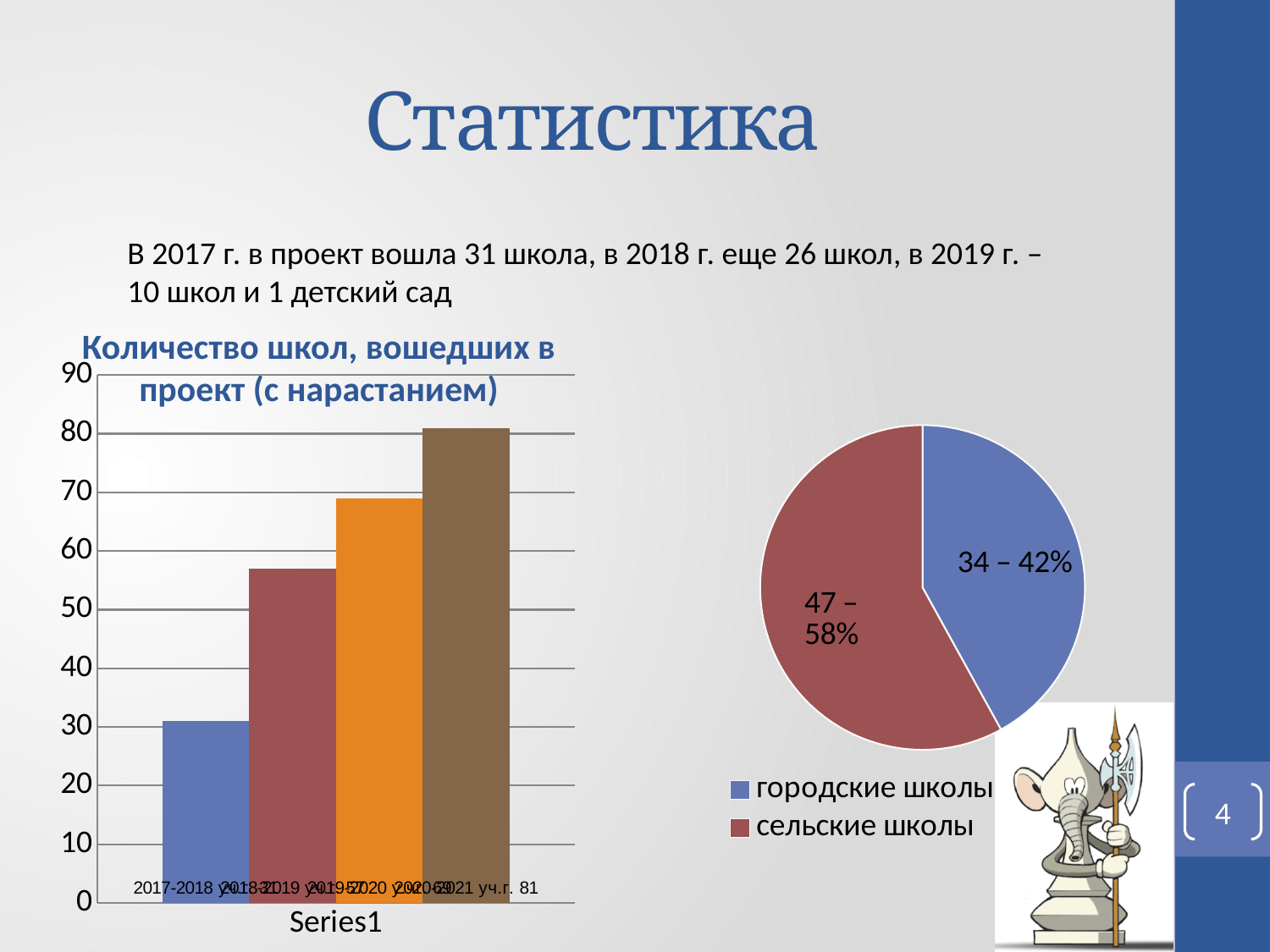
In the bar chart "Количество школ, вошедших в проект (с нарастанием)", which category has the highest bar? 2020-2021 уч.г. In the pie chart on the right, what share of the pie is городские школы? 42% In the bar chart "Количество школ, вошедших в проект (с нарастанием)", what is the value for 2020-2021 уч.г.? 81 In the bar chart "Количество школ, вошедших в проект (с нарастанием)", is the value for 2017-2018 уч.г. greater or less than 40? less In the bar chart "Количество школ, вошедших в проект (с нарастанием)", which category has the lowest bar? 2017-2018 уч.г. In the pie chart on the right, how many entries does the legend list? 2 In the bar chart "Количество школ, вошедших в проект (с нарастанием)", do the values rise or fall from left to right? rise In the pie chart on the right, what is the value shown for сельские школы? 47 What kind of chart is the chart on the right of the slide? pie chart What kind of chart is the chart on the left, titled "Количество школ, вошедших в проект (с нарастанием)"? bar chart In the bar chart "Количество школ, вошедших в проект (с нарастанием)", is the value for 2018-2019 уч.г. greater or less than 50? greater In the bar chart "Количество школ, вошедших в проект (с нарастанием)", how many bars are plotted? 4